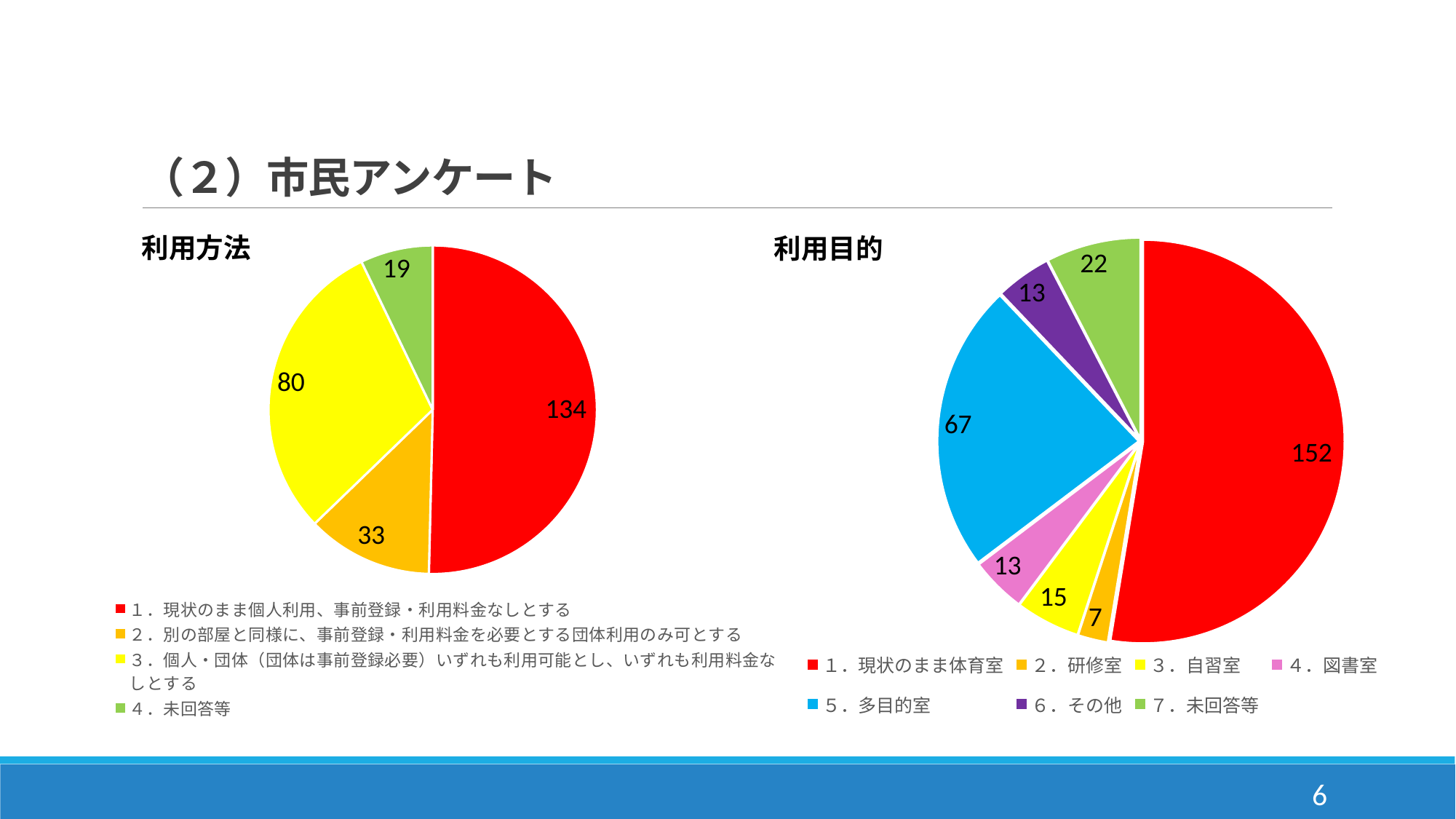
In the 利用方法 pie chart on the left, how many categories are shown? 4 In the 利用目的 pie chart on the right, which category has the largest slice? １．現状のまま体育室 What type of chart is used for 利用方法 on the left? Pie chart In the 利用目的 pie chart on the right, which is larger: 「３．自習室」 or 「７．未回答等」? ７．未回答等 In the 利用目的 pie chart on the right, how many categories does the legend list? 7 In the 利用方法 pie chart on the left, what is the difference between the values for 「３．個人・団体…」 and 「２．別の部屋と同様に…」? 47 In the 利用方法 pie chart on the left, which category has the smallest slice? ４．未回答等 In the 利用目的 pie chart on the right, what is the value for 「５．多目的室」? 67 In the 利用方法 pie chart on the left, what is the value for 「３．個人・団体（団体は事前登録必要）いずれも利用可能とし、いずれも利用料金なしとする」? 80 In the 利用目的 pie chart on the right, what is the difference between the values for 「１．現状のまま体育室」 and 「５．多目的室」? 85 In the 利用方法 pie chart on the left, what is the value for 「１．現状のまま個人利用、事前登録・利用料金なしとする」? 134 In the 利用目的 pie chart on the right, what is the value for 「２．研修室」? 7